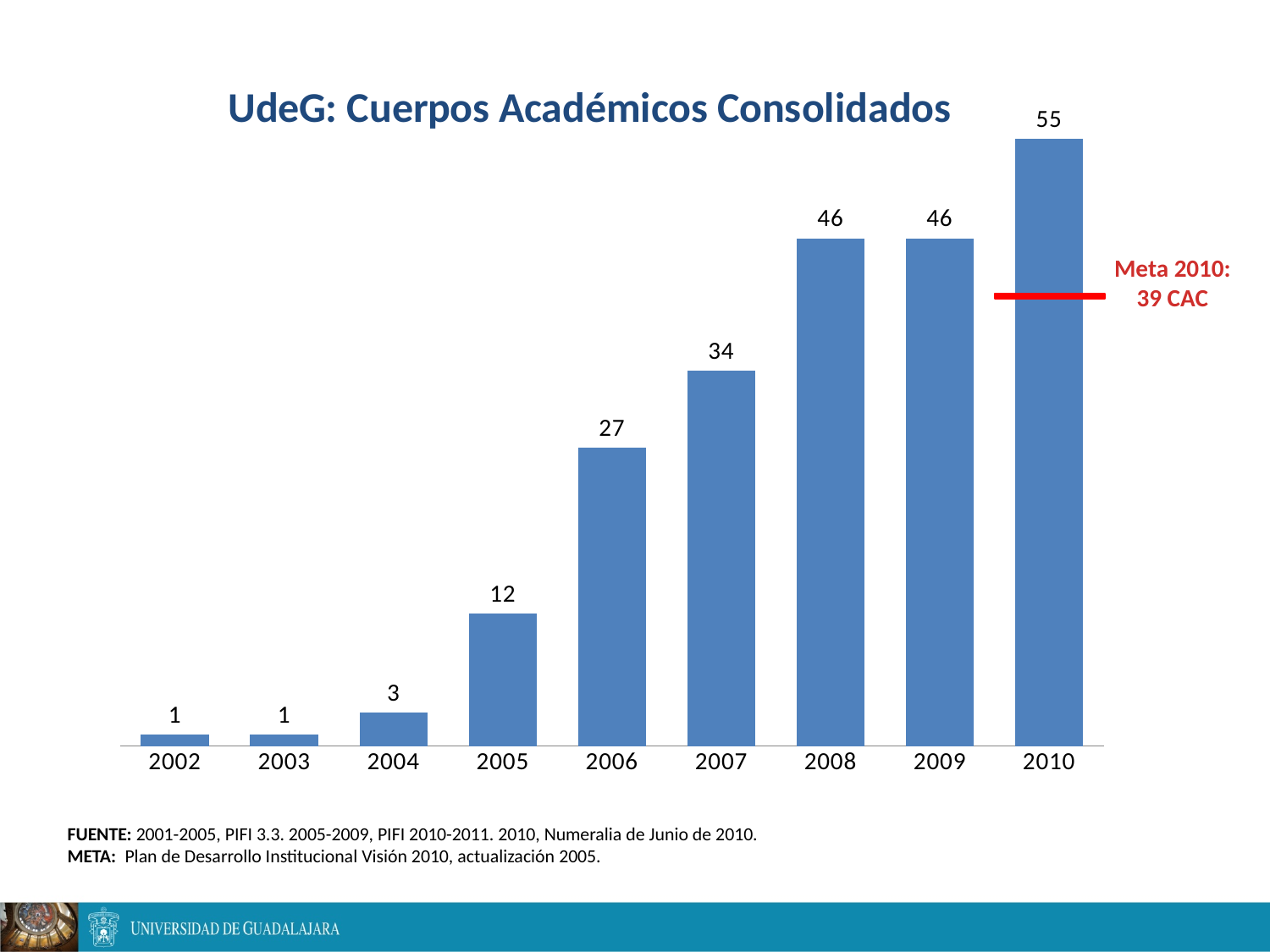
What is the difference between the values for 2007 and 2006? 7 What is the value for 2006? 27 Do the values generally rise or fall from 2002 to 2010? rise What is the value for 2004? 3 What is the title of the chart? UdeG: Cuerpos Académicos Consolidados Which is larger, the value for 2005 or the value for 2007? 2007 What kind of chart is shown on the slide? bar chart What is the difference between the values for 2010 and 2009? 9 How many years are shown on the x axis? 9 What is the value for 2010? 55 What target value does the red line labelled 'Meta 2010' indicate? 39 CAC Which year has the highest value? 2010